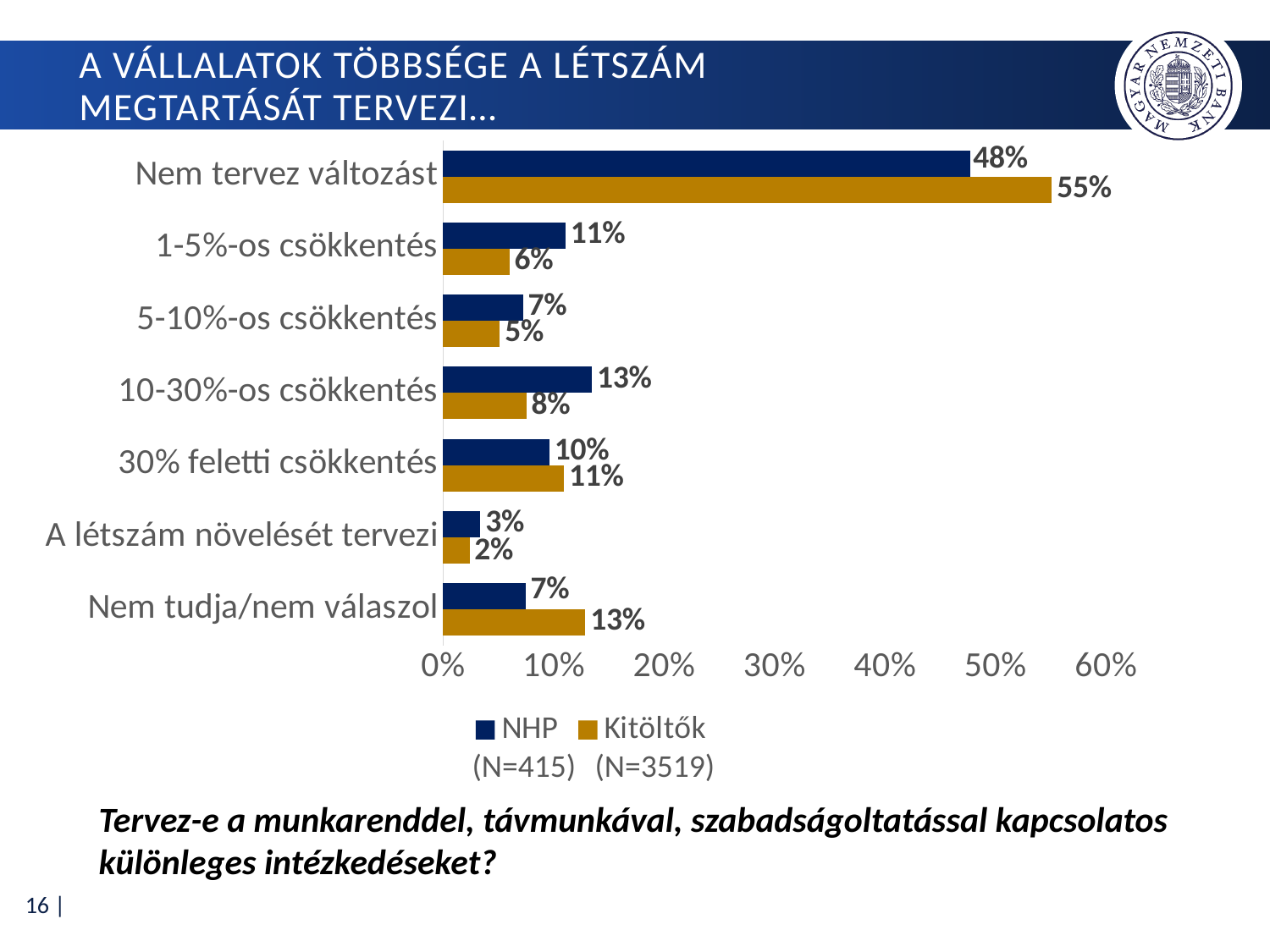
What is the Kitöltők value for '10-30%-os csökkentés'? 8% How many series does the legend list? 2 How many categories are shown on the chart? 7 What is the Kitöltők value for 'Nem tudja/nem válaszol'? 13% Which category has the highest Kitöltők value? Nem tervez változást What kind of chart is shown on the slide? Bar chart For '1-5%-os csökkentés', which series has the larger value, NHP or Kitöltők? NHP What is the NHP value for 'Nem tervez változást'? 48% What sample size is given for the Kitöltők series in the legend? N=3519 Which category has the lowest NHP value? A létszám növelését tervezi What is the difference between the Kitöltők and NHP values for 'Nem tervez változást'? 7 percentage points Is the Kitöltők value for 'Nem tervez változást' greater or less than 50%? greater